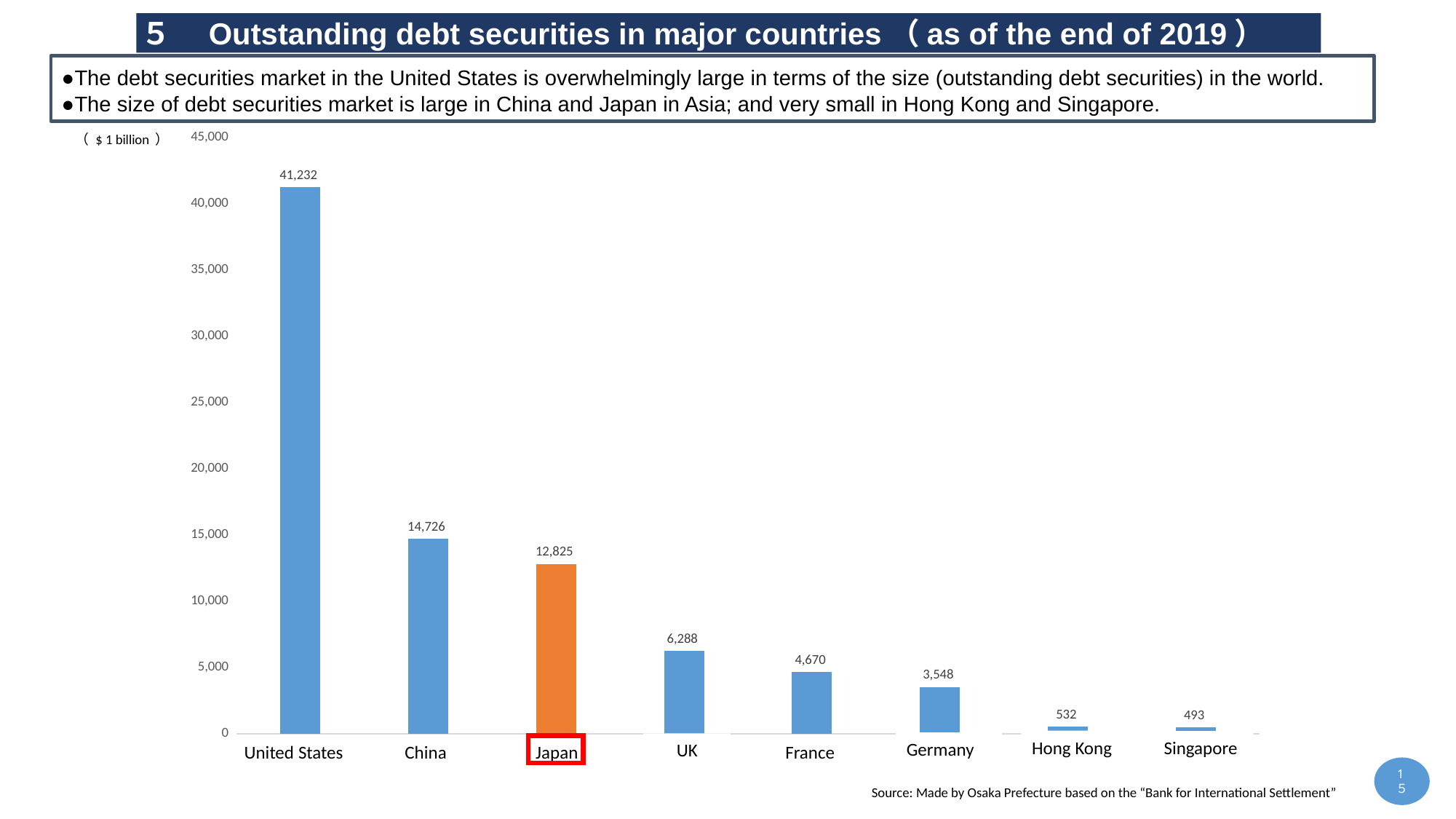
Which country has the highest outstanding debt securities? United States Which is larger, the value for the UK or the value for France? UK Do the values rise or fall from left to right across the countries? fall What is the difference between the values for China and Japan? 1,901 Which country has the lowest outstanding debt securities? Singapore What is the value of outstanding debt securities for the United States? 41,232 What is the value shown for Hong Kong? 532 Which country's bar is coloured orange instead of blue? Japan Is the value for Germany greater or less than 5,000? less What is the value of outstanding debt securities for Japan? 12,825 What kind of chart is shown on the slide? bar chart How many countries are shown in the chart? 8